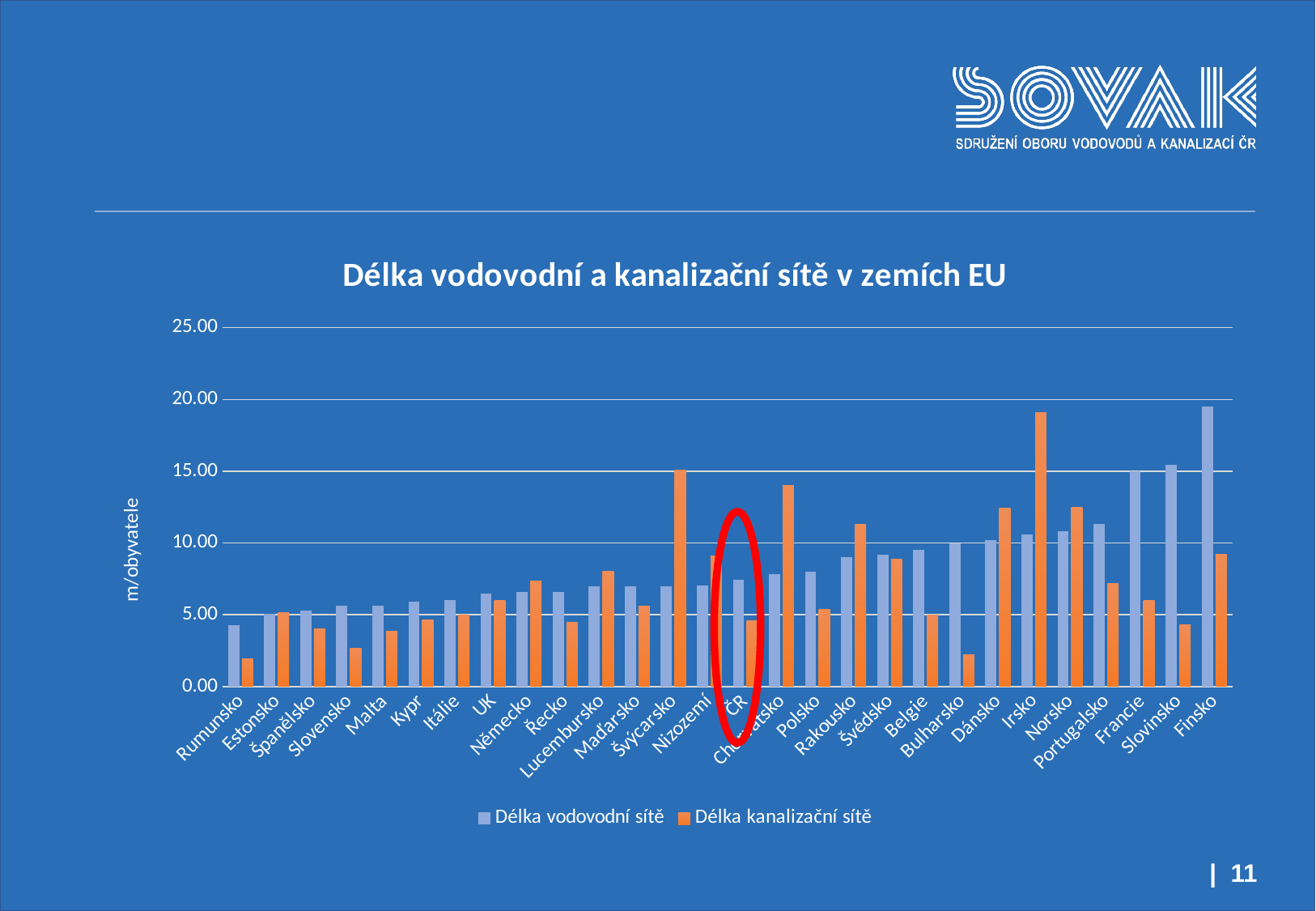
Which country has the highest value for Délka kanalizační sítě? Irsko How many countries are shown on the x axis? 28 How many series does the legend list? 2 Is the value of Délka kanalizační sítě for Rumunsko greater or less than 5.00? less Do the values of Délka vodovodní sítě generally rise or fall from left to right along the x axis? rise Is the value of Délka vodovodní sítě for Finsko greater or less than 15.00? greater Which country has the lowest value for Délka kanalizační sítě? Rumunsko What is the title of the chart? Délka vodovodní a kanalizační sítě v zemích EU For Irsko, which is larger: Délka vodovodní sítě or Délka kanalizační sítě? Délka kanalizační sítě What kind of chart is shown on the slide? bar chart Is the value of Délka kanalizační sítě for Švýcarsko greater or less than 10.00? greater Which country has the highest value for Délka vodovodní sítě? Finsko